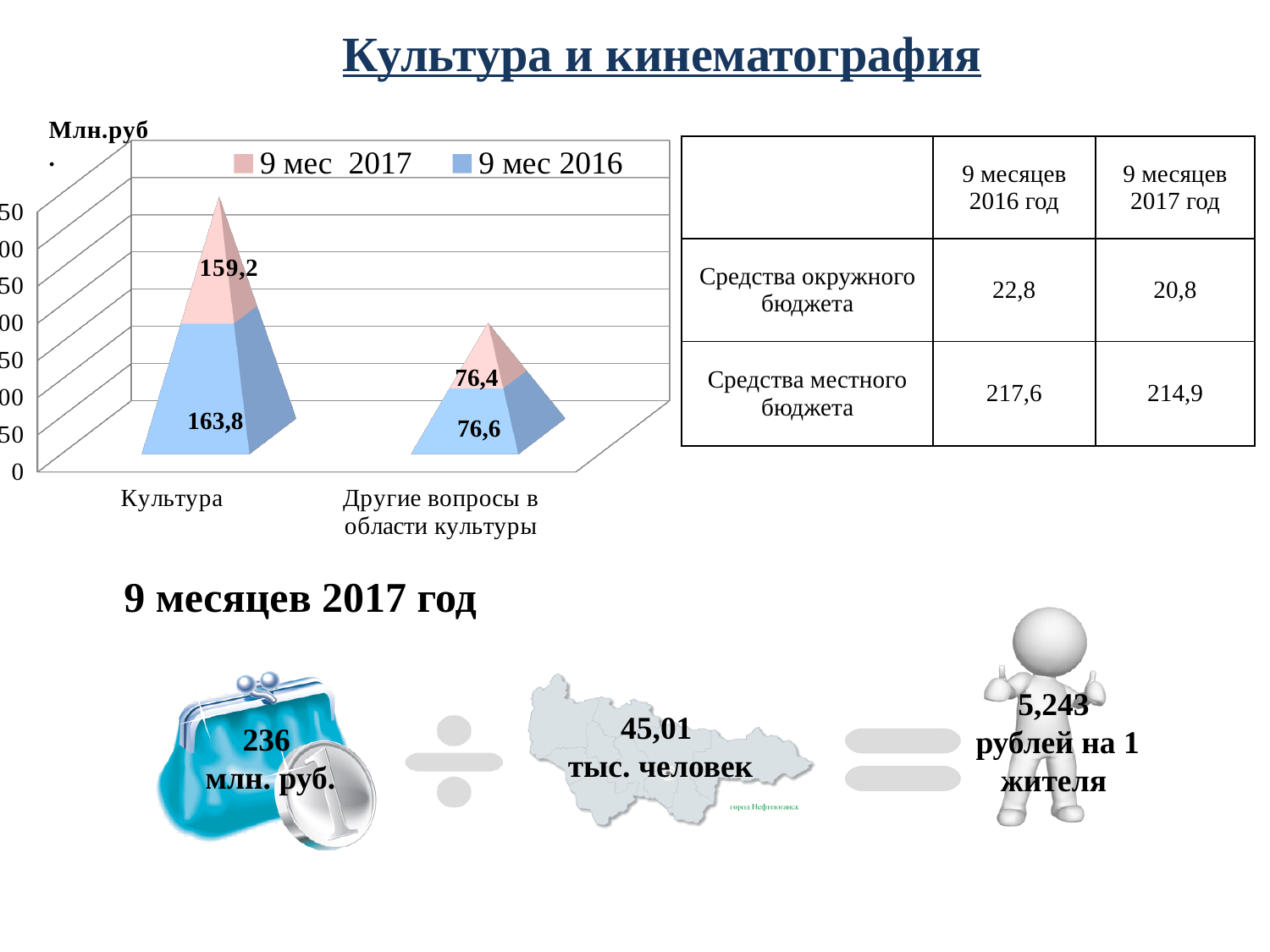
What is the value for Другие вопросы в области культуры in the 9 мес 2017 series? 76,4 What is the difference between the 9 мес 2016 values for Культура and Другие вопросы в области культуры? 87,2 Which category has the highest value in the 9 мес 2017 series? Культура What is the value for Культура in the 9 мес 2016 series? 163,8 What is the difference between the 9 мес 2016 and 9 мес 2017 values for Культура? 4,6 What is the value for Культура in the 9 мес 2017 series? 159,2 How many series does the chart legend list? 2 What unit is indicated above the chart's vertical axis? Млн.руб. How many categories are shown on the x axis of the chart? 2 For Культура, which series has the larger value: 9 мес 2016 or 9 мес 2017? 9 мес 2016 Which category has the lowest value in the 9 мес 2016 series? Другие вопросы в области культуры What is the value for Другие вопросы в области культуры in the 9 мес 2016 series? 76,6